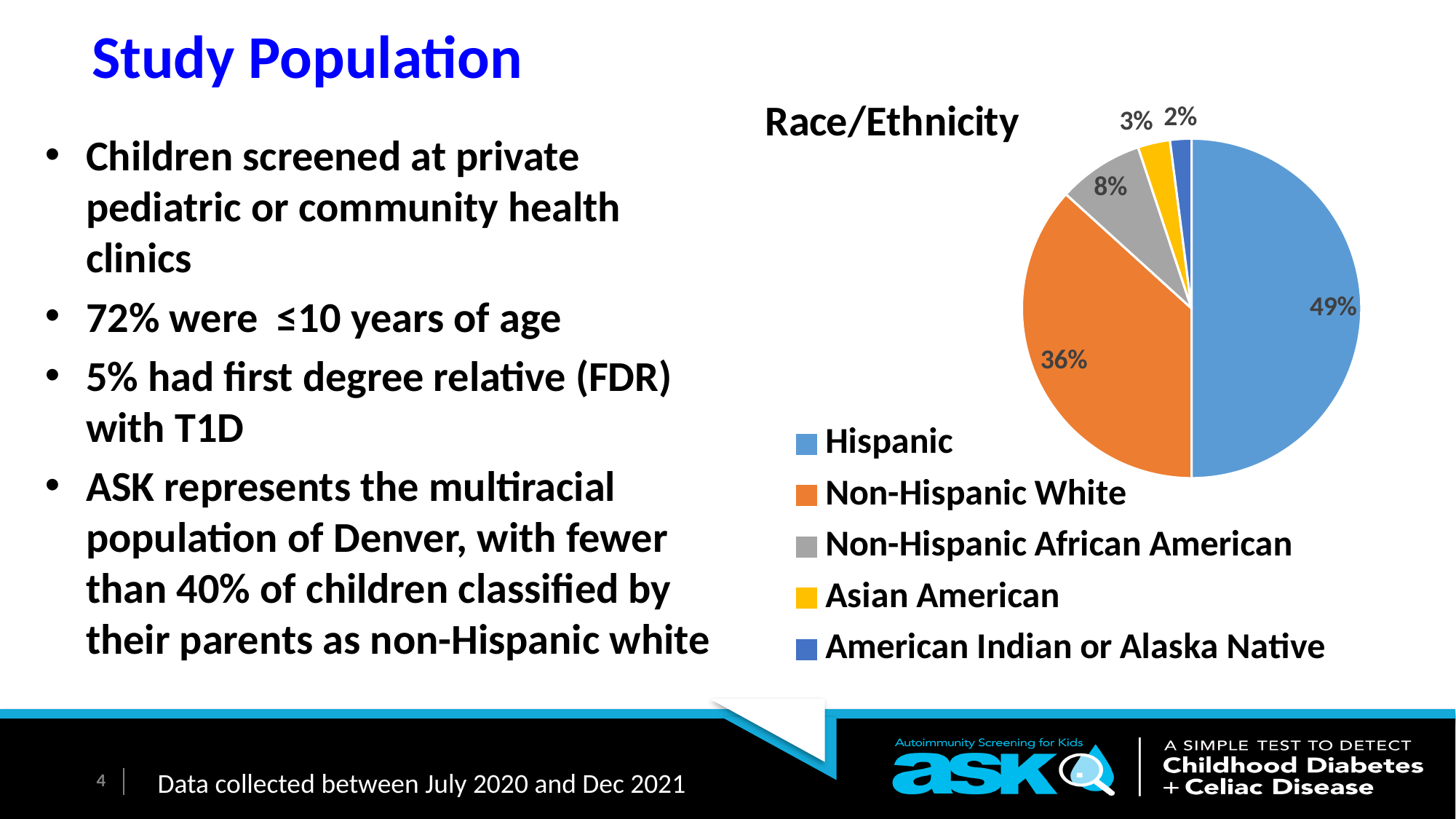
Which is larger in the pie chart, Non-Hispanic African American or Asian American? Non-Hispanic African American What share of the Race/Ethnicity pie is Hispanic? 49% What is the value shown for Non-Hispanic African American in the pie chart? 8% What percentage does the Asian American slice represent? 3% Which category has the largest slice of the pie chart? Hispanic What is the difference in percentage points between the Hispanic and Non-Hispanic White slices? 13 What is the title of the chart? Race/Ethnicity What type of chart is shown on the slide? Pie chart What percentage of the pie chart is Non-Hispanic White? 36% What is the value for American Indian or Alaska Native in the pie chart? 2% Which category has the smallest slice of the pie chart? American Indian or Alaska Native How many categories does the pie chart show? 5